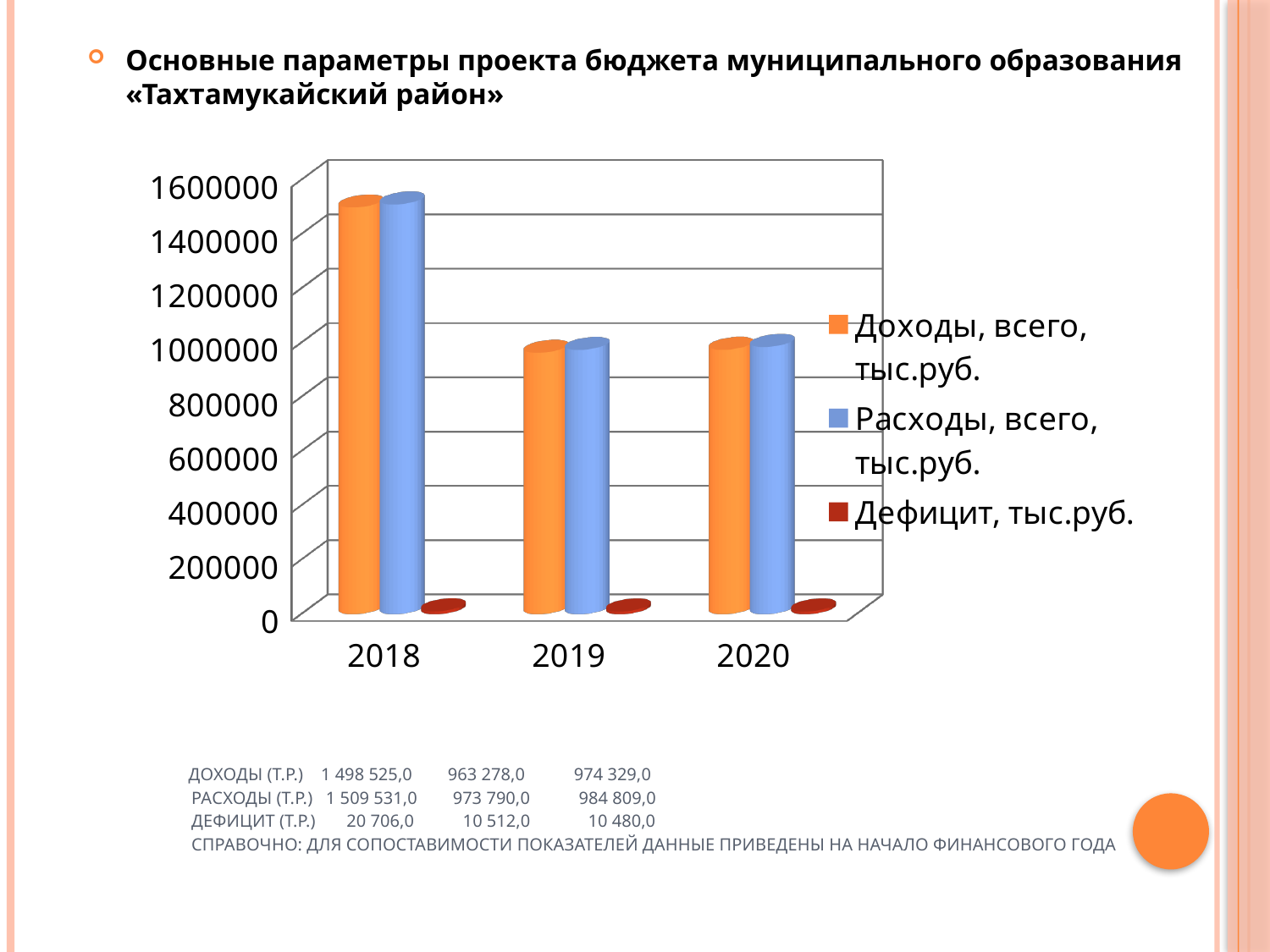
How many series does the chart legend list? 3 Which is larger: Расходы, всего in 2019 or in 2020? 2020 Do the Доходы, всего values rise or fall from 2018 to 2019? fall What is the value of Расходы, всего (тыс.руб.) for 2020? 984 809,0 What is the value of Доходы, всего (тыс.руб.) for 2018? 1 498 525,0 Is the value of Расходы, всего for 2018 greater or less than 1400000? greater What kind of chart is shown on the slide? bar chart What is the difference between Доходы, всего in 2018 and in 2019? 535 247,0 In which year is Доходы, всего the highest? 2018 Is the value of Доходы, всего for 2019 greater or less than 1000000? less What is the value of Дефицит (тыс.руб.) for 2019? 10 512,0 How many years are shown on the x axis of the chart? 3